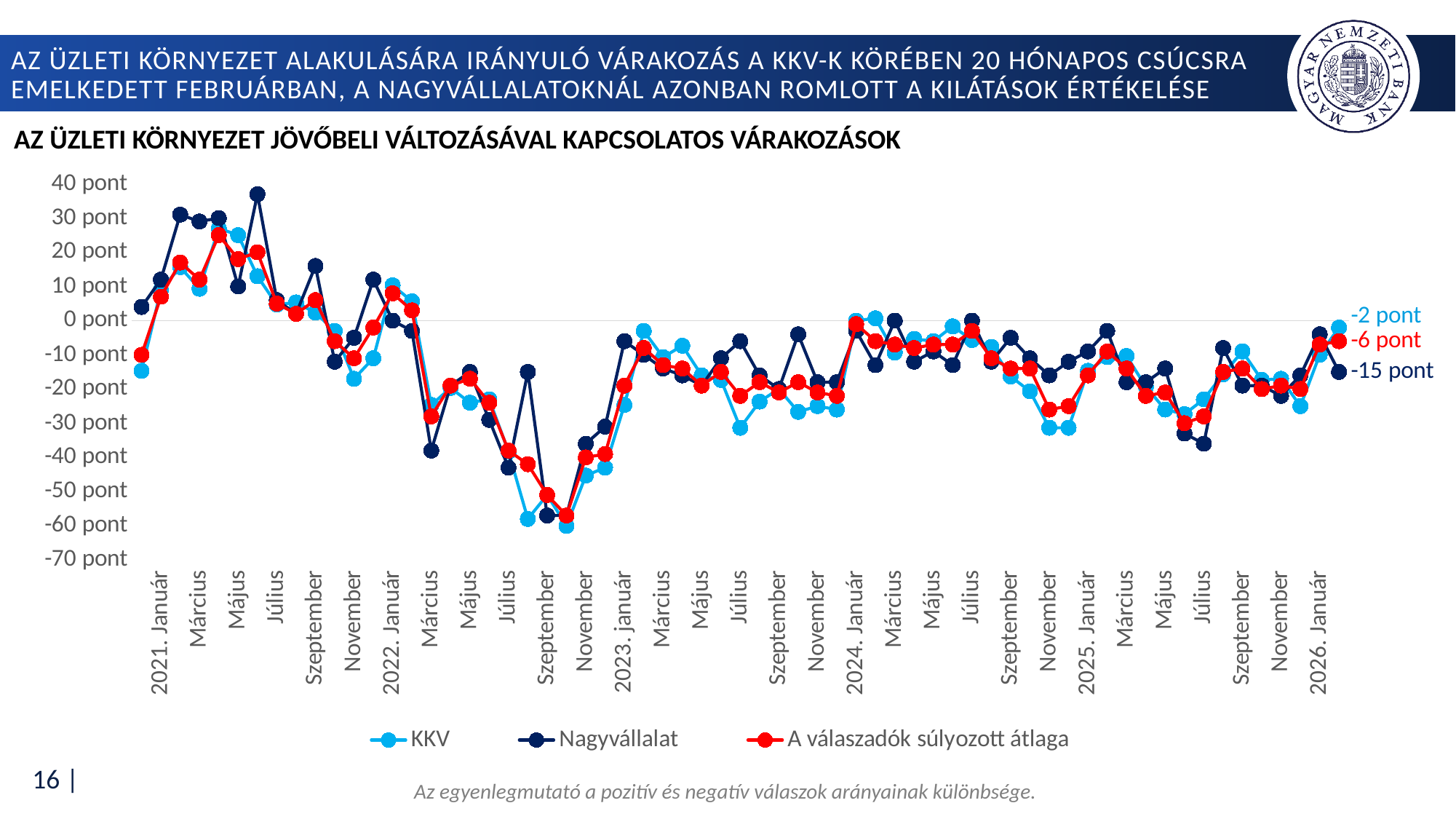
What is the latest value shown for the 'A válaszadók súlyozott átlaga' series? -6 pont At the latest data point, which is larger: the value for 'A válaszadók súlyozott átlaga' or the value for Nagyvállalat? A válaszadók súlyozott átlaga How many series does the legend list? 3 What is the title of the chart? AZ ÜZLETI KÖRNYEZET JÖVŐBELI VÁLTOZÁSÁVAL KAPCSOLATOS VÁRAKOZÁSOK What is the difference between the latest KKV value and the latest Nagyvállalat value? 13 pont Is the lowest value reached by the KKV series greater or less than -50 pont? less What is the latest value shown for the KKV series? -2 pont What kind of chart is shown on the slide? line chart At the latest data point, which series has the higher value: KKV or Nagyvállalat? KKV What is the latest value shown for the Nagyvállalat series? -15 pont Is the highest value reached by the Nagyvállalat series greater or less than 30 pont? greater Which series reaches the highest value anywhere on the chart? Nagyvállalat